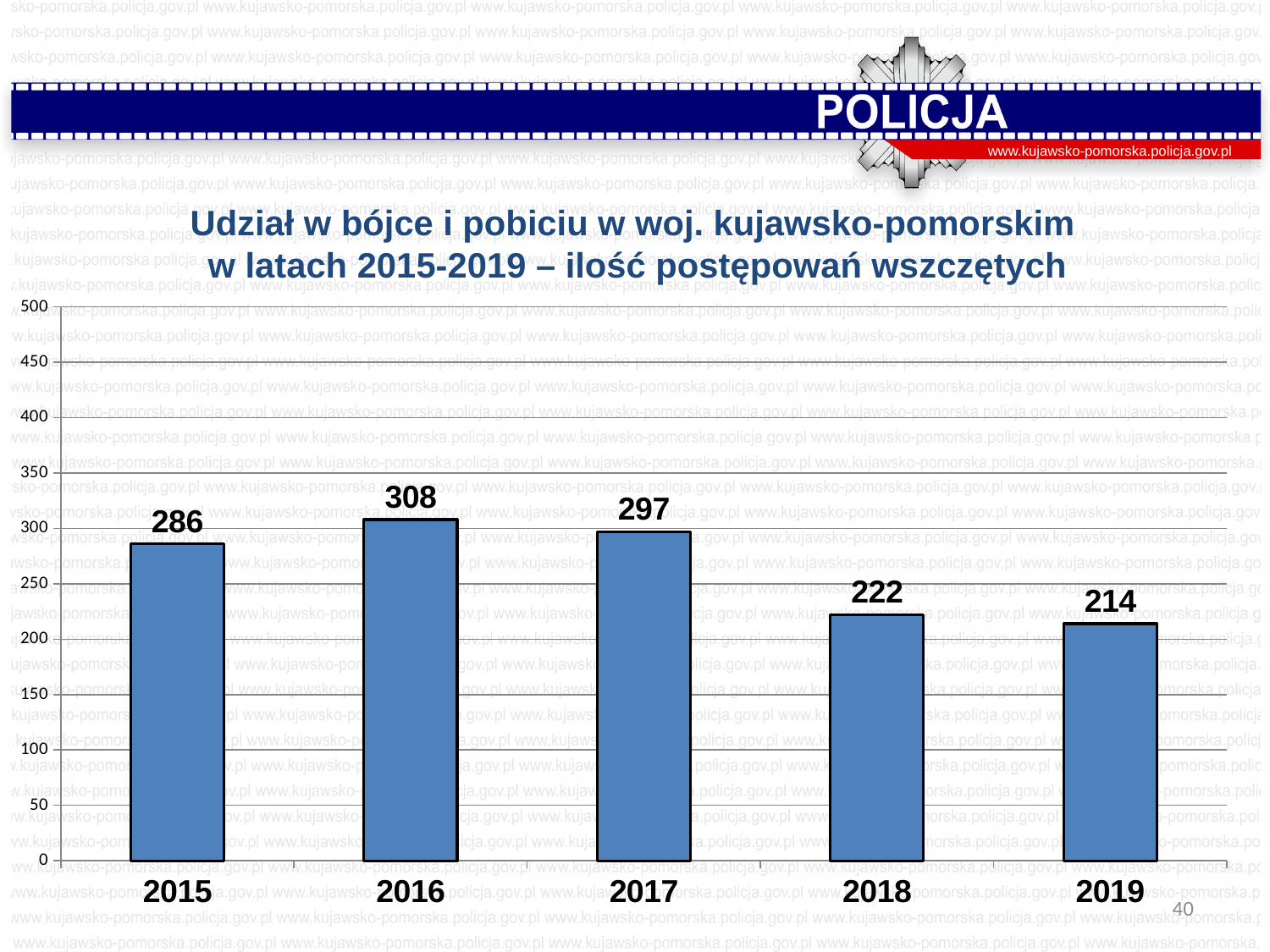
What is the highest value shown on the y axis? 500 What kind of chart is shown on the slide? bar chart Which year has the highest value? 2016 What value is shown for 2015? 286 How many years are shown on the x axis? 5 What is the difference between the values for 2017 and 2018? 75 What is the difference between the values for 2016 and 2019? 94 Is the value for 2016 greater or less than 300? greater Do the values rise or fall from 2017 to 2019? fall Which year has the lowest value? 2019 What value is shown for 2018? 222 Which is larger, the value for 2015 or the value for 2017? 2017